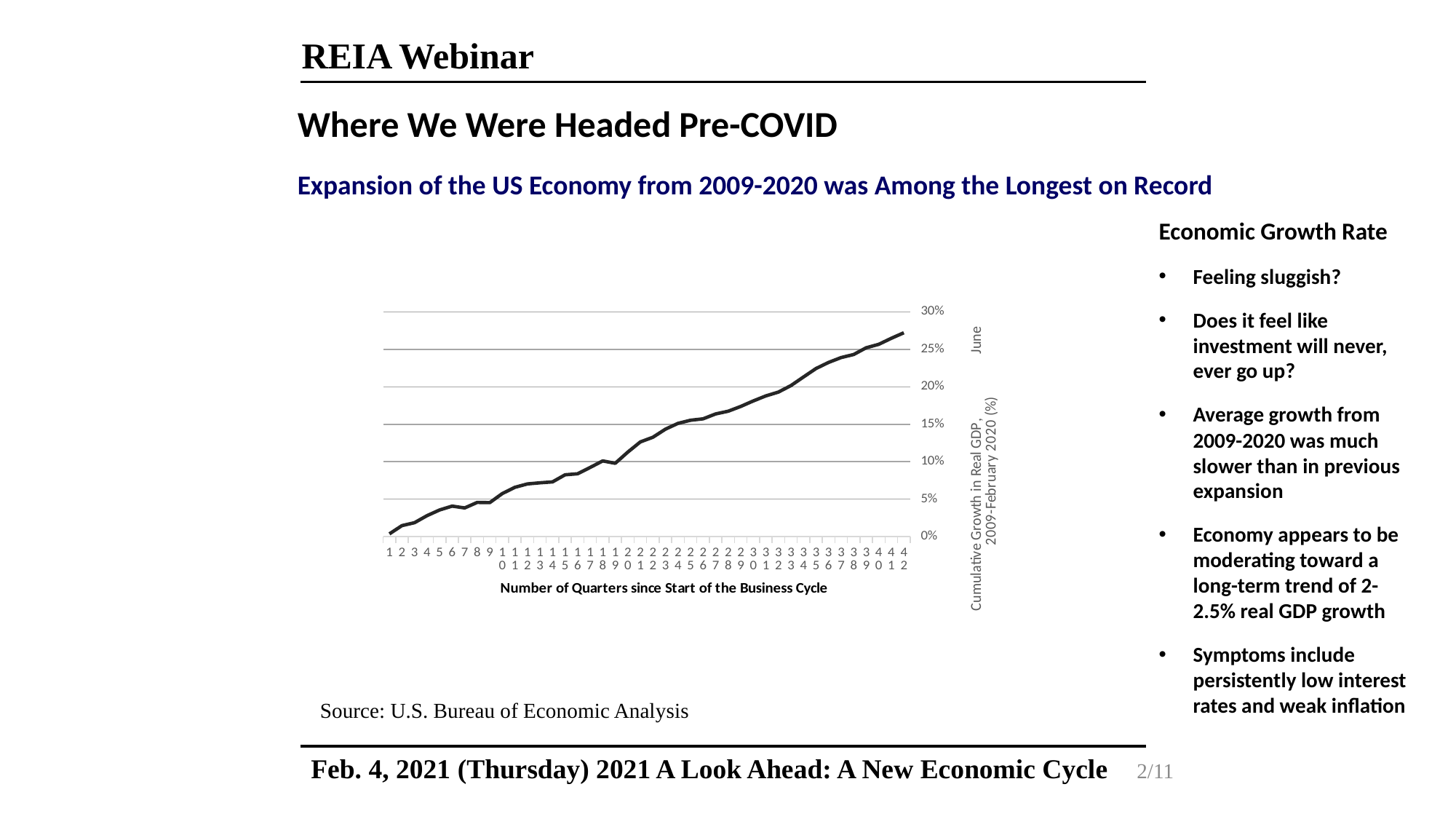
Is the cumulative growth at quarter 20 greater or less than 10%? greater What is the title of the x axis of the chart? Number of Quarters since Start of the Business Cycle Is the cumulative growth at quarter 42 greater or less than 25%? greater Is the cumulative growth at quarter 30 greater or less than 15%? greater At which quarter is the cumulative growth in real GDP highest? 42 How many quarters are plotted along the x axis of the chart? 42 Do the values on the chart generally rise or fall as the number of quarters increases? rise At which quarter is the cumulative growth in real GDP lowest? 1 What kind of chart is shown on the slide? line chart What is the highest value shown on the y axis of the chart? 30%